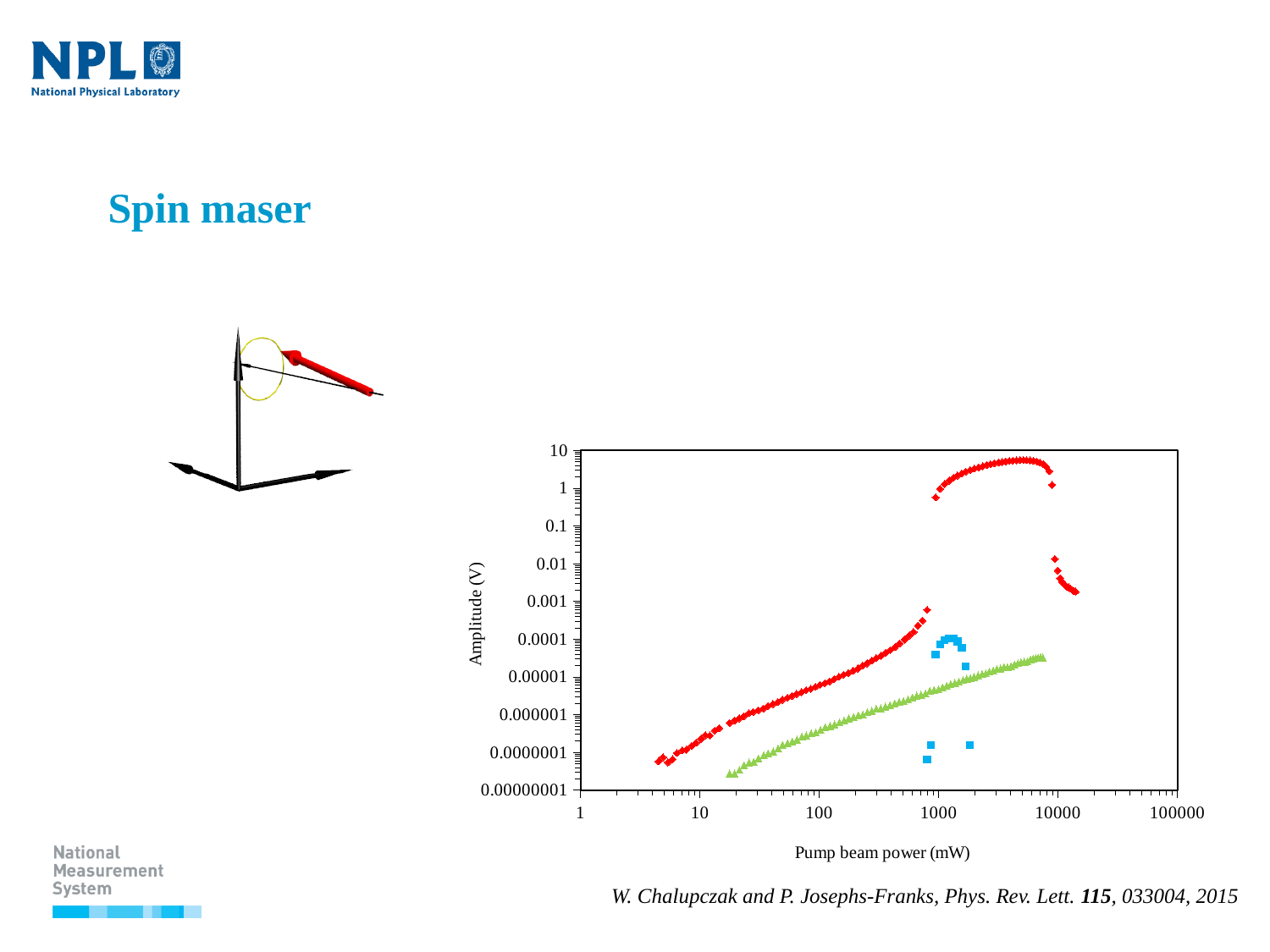
At a pump beam power of 1000 mW, which series has the larger amplitude, the red diamonds or the green triangles? red diamonds Is the highest amplitude of the green triangle series greater or less than 0.0001? less What is the label of the vertical axis of the chart? Amplitude (V) Which series reaches the highest amplitude on the chart: red diamonds, green triangles or blue squares? red diamonds What is the highest tick value shown on the vertical axis? 10 What is the label of the horizontal axis of the chart? Pump beam power (mW) What kind of chart is shown on the slide? scatter chart What is the highest tick value shown on the horizontal axis? 100000 Does the amplitude of the green triangle series rise or fall as pump beam power increases? rise What is the lowest tick value shown on the vertical axis? 0.00000001 Is the peak amplitude of the red diamond series greater or less than 1? greater